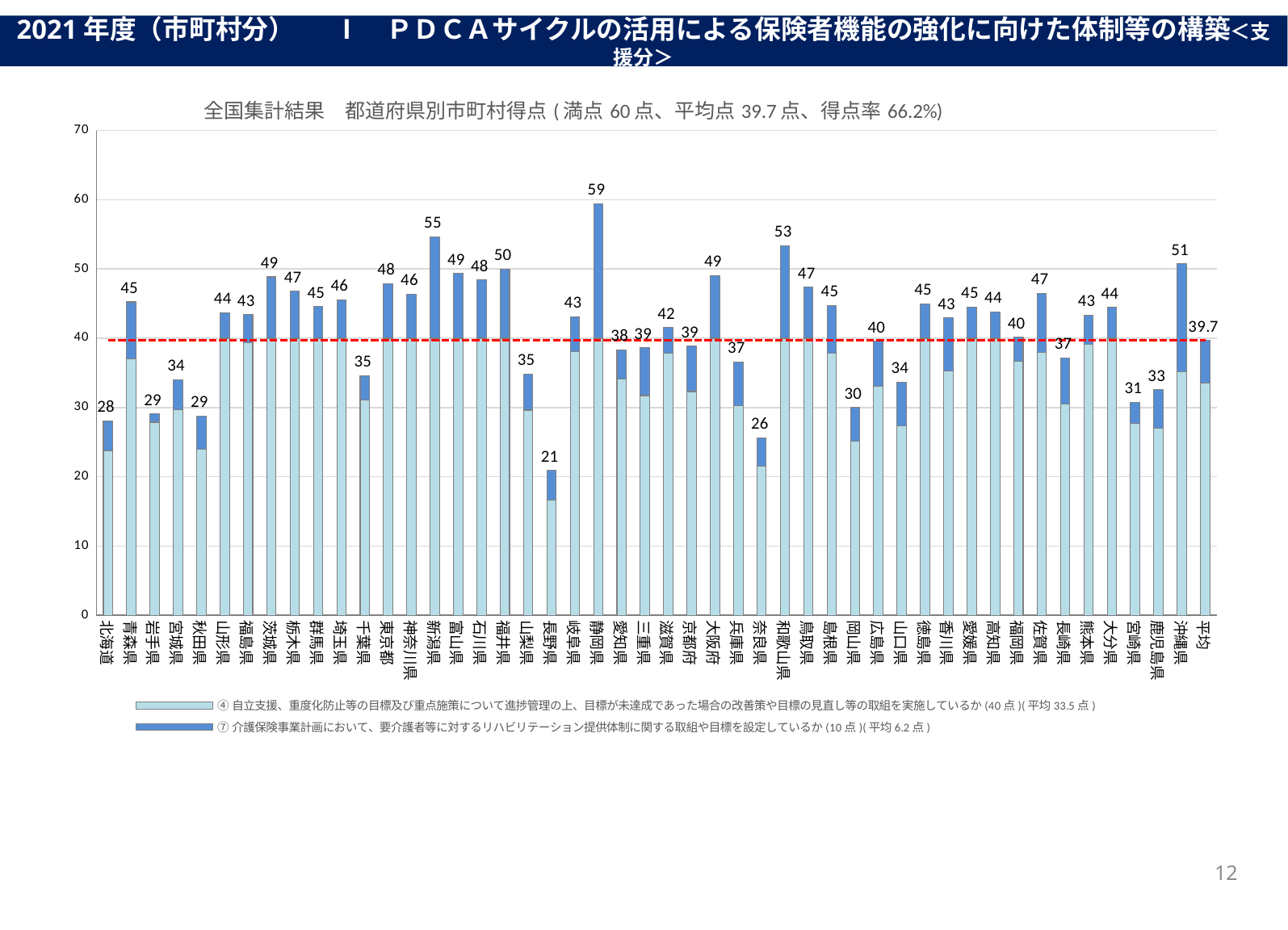
Which prefecture has the lowest total score? 長野県 What is the total score shown for 沖縄県? 51 Is the light blue segment for 長野県 greater or less than 20? less What value does the red dashed horizontal line correspond to? 39.7 What is the total score shown for 静岡県? 59 Which prefecture has the highest total score? 静岡県 What value is shown for the 平均 (average) bar at the far right? 39.7 What is the difference between the total scores of 静岡県 and 長野県? 38 What is the total score shown for 北海道? 28 Which has a higher total score, 新潟県 or 和歌山県? 新潟県 How many series does the legend list? 2 What kind of chart is shown on the slide? Stacked bar chart